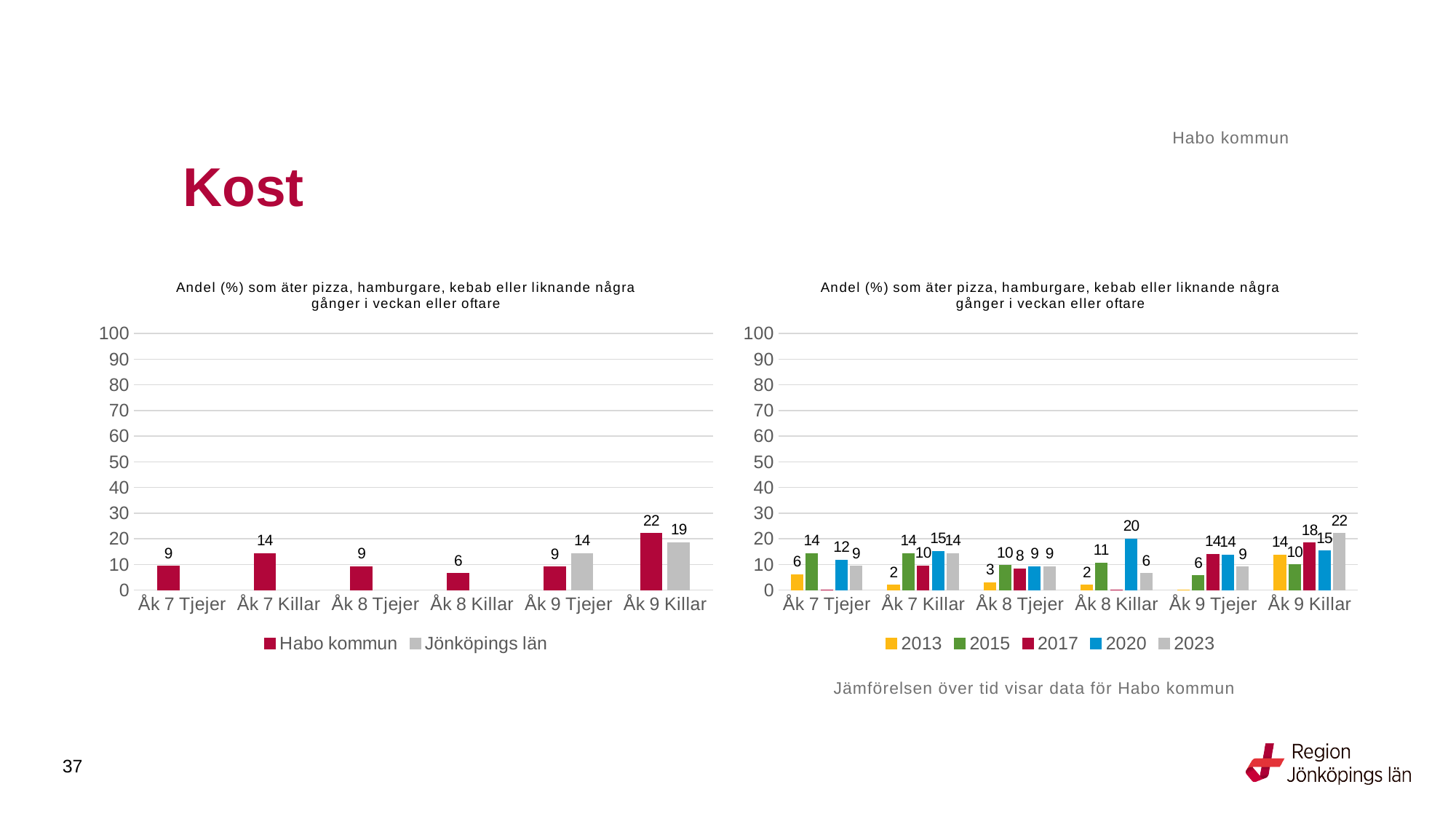
In the right chart, what is the value for 2013 for Åk 7 Tjejer? 6 In the left chart, which category has the highest Habo kommun value? Åk 9 Killar In the left chart, what is the value for Habo kommun for Åk 9 Killar? 22 In the left chart, what is the difference between Habo kommun and Jönköpings län for Åk 9 Killar? 3 How many series does the legend of the left chart list? 2 In the right chart, what is the value for 2020 for Åk 8 Killar? 20 In the right chart, which is larger for Åk 9 Killar: 2017 or 2023? 2023 In the left chart, which category has the lowest Habo kommun value? Åk 8 Killar How many series does the legend of the right chart list? 5 What type of chart is the right chart? Bar chart In the right chart, what is the difference between the 2015 and 2013 values for Åk 7 Killar? 12 In the left chart, what is the value for Jönköpings län for Åk 9 Tjejer? 14